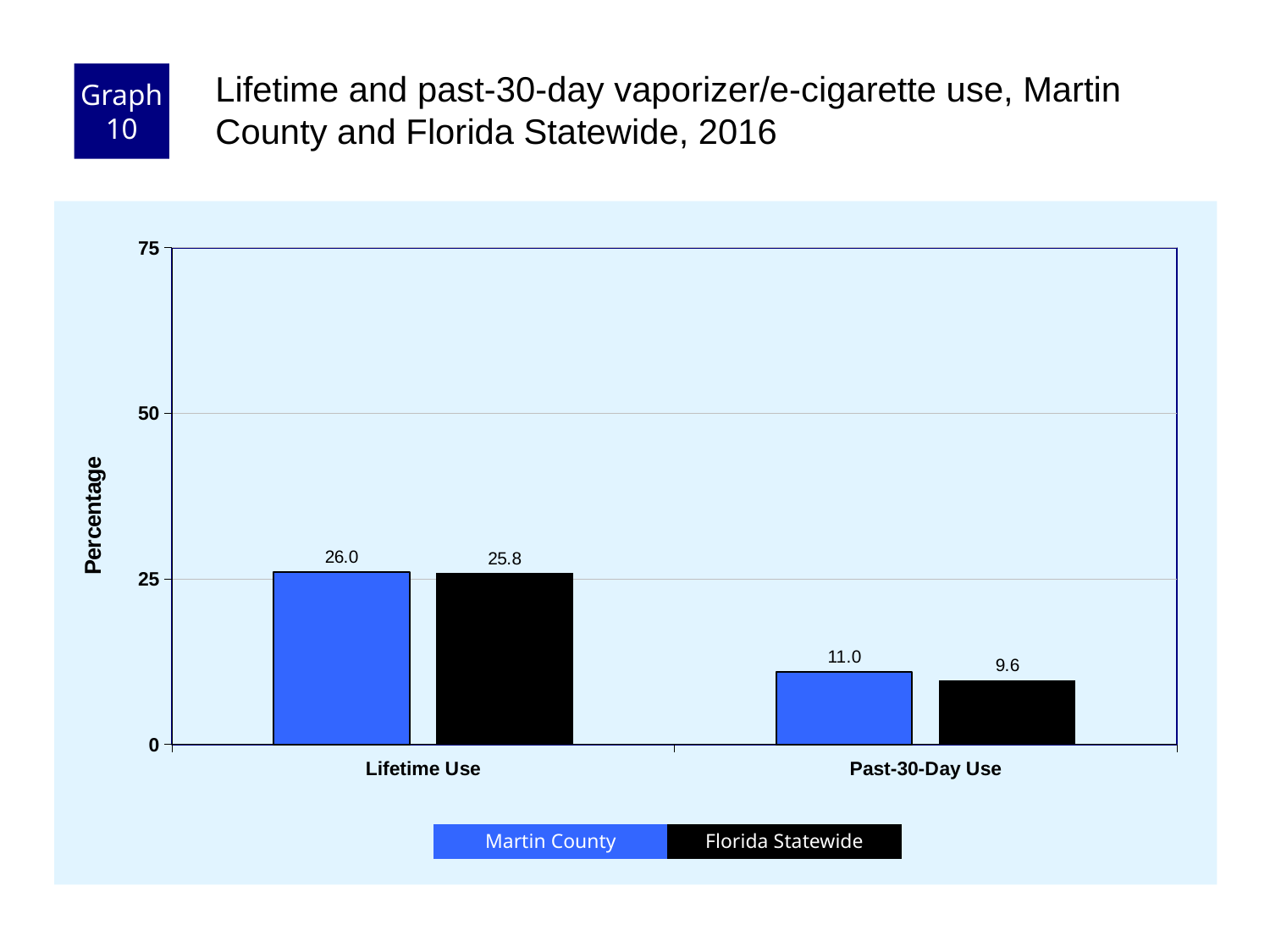
Which category has the highest Martin County value? Lifetime Use What is the difference between the Martin County values for Lifetime Use and Past-30-Day Use? 15.0 What is the Martin County value for Lifetime Use? 26.0 How many series does the legend list? 2 How many categories are shown on the x axis? 2 Which category has the lowest Florida Statewide value? Past-30-Day Use What is the difference between the Martin County and Florida Statewide values for Past-30-Day Use? 1.4 What is the Florida Statewide value for Past-30-Day Use? 9.6 What is the Florida Statewide value for Lifetime Use? 25.8 Which is larger: the Martin County value for Lifetime Use or the Martin County value for Past-30-Day Use? Lifetime Use What is the Martin County value for Past-30-Day Use? 11.0 What kind of chart is shown on the slide? Bar chart